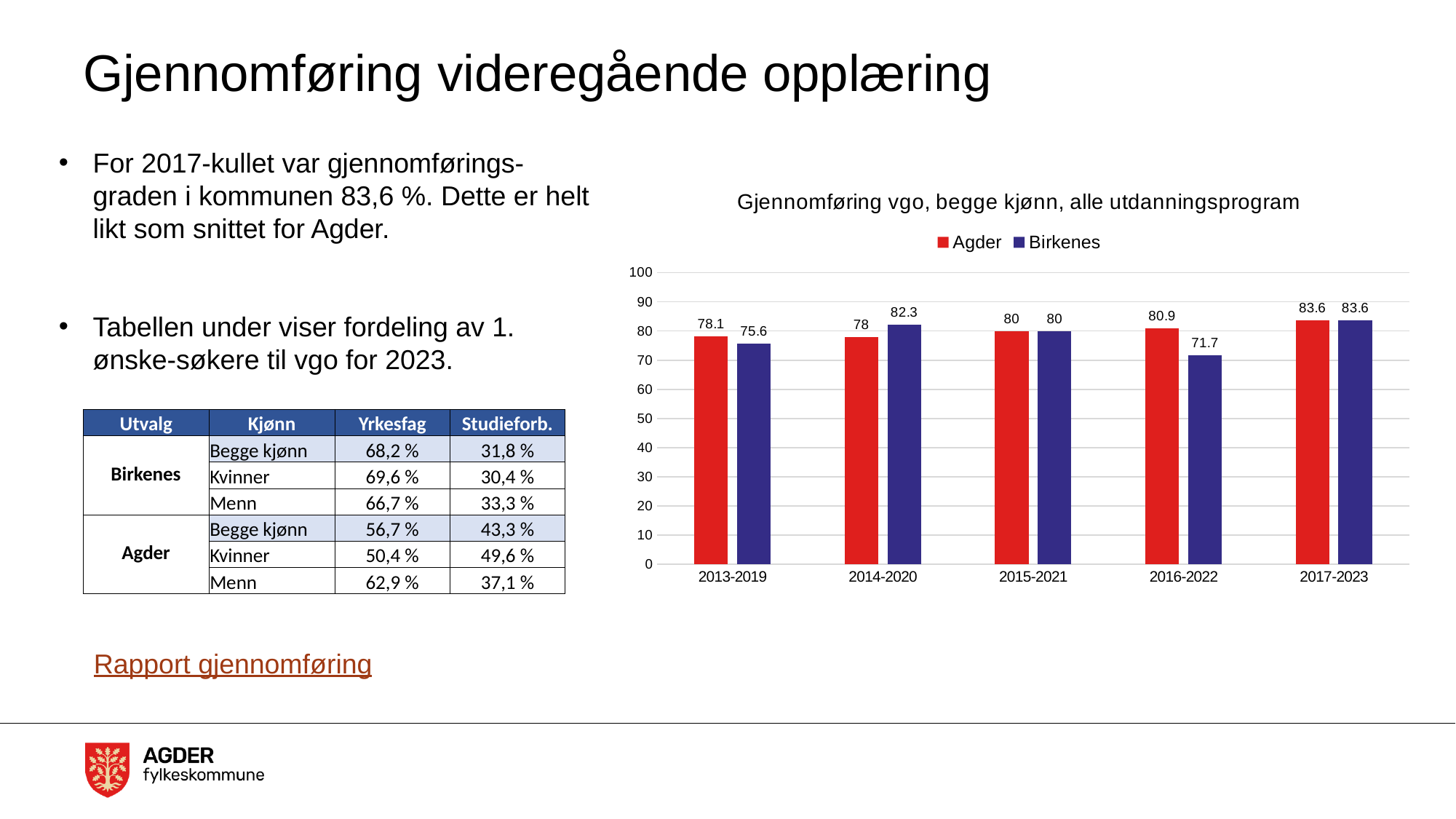
What is the value for Agder in 2013-2019? 78.1 Which period has the lowest value for Birkenes? 2016-2022 How many series does the legend list? 2 What is the title of the chart? Gjennomføring vgo, begge kjønn, alle utdanningsprogram What is the difference between Agder and Birkenes in 2016-2022? 9.2 What is the value for Birkenes in 2016-2022? 71.7 Which is larger in 2014-2020, Agder or Birkenes? Birkenes Is the value for Birkenes in 2013-2019 greater or less than 80? less How many periods are shown on the x axis? 5 What is the value for Birkenes in 2014-2020? 82.3 Which period has the highest value for Agder? 2017-2023 What kind of chart is shown? bar chart